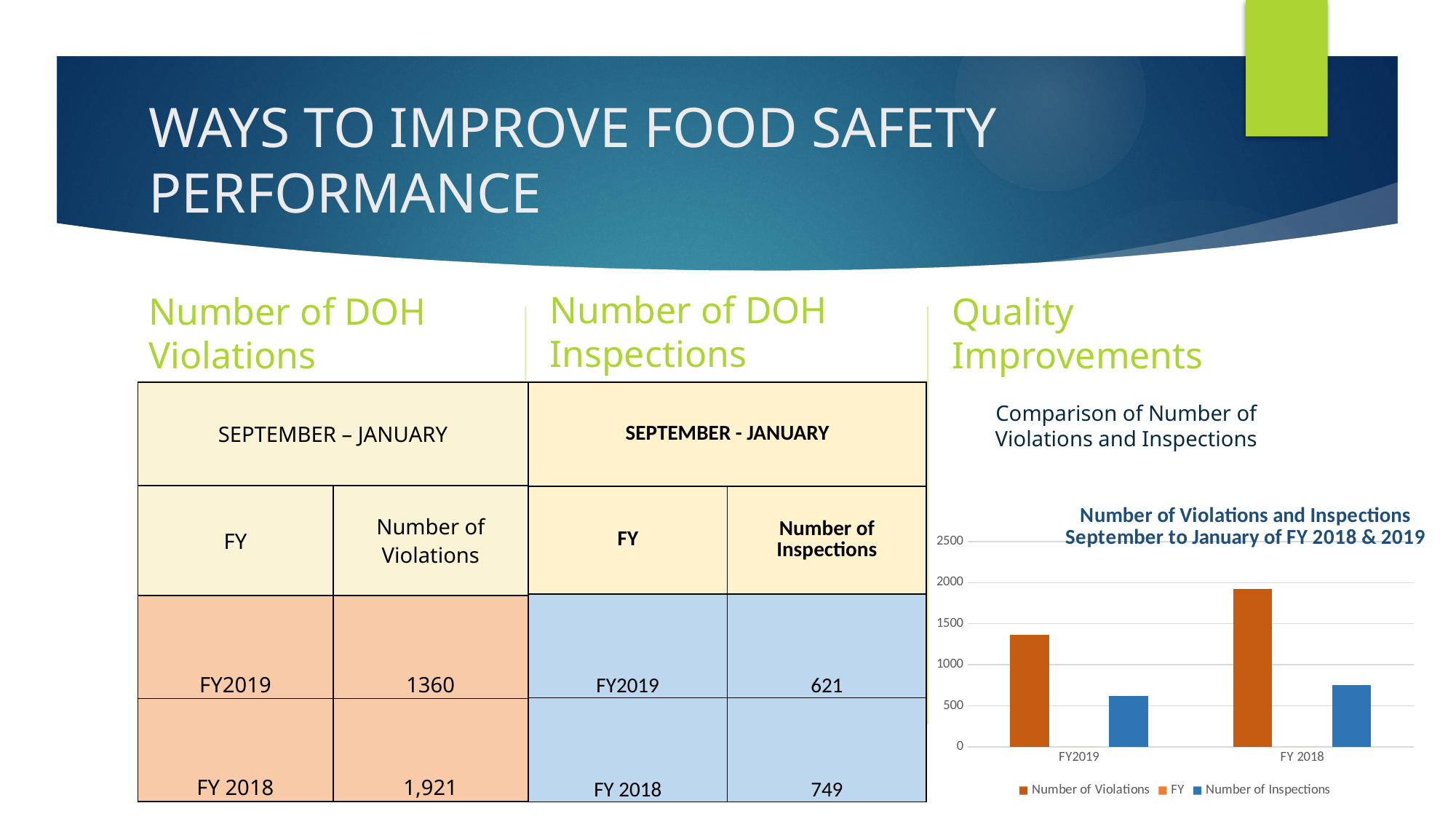
In the chart, is the Number of Violations bar for FY 2018 greater or less than 1500? greater How many entries does the chart's legend list? 3 In the chart, is the Number of Inspections bar for FY 2018 greater or less than 500? greater How many fiscal year categories are shown on the x axis of the chart? 2 In the chart, which fiscal year has the taller Number of Inspections bar, FY2019 or FY 2018? FY 2018 In the chart, which fiscal year has the taller Number of Violations bar, FY2019 or FY 2018? FY 2018 In the chart, is the Number of Violations bar for FY2019 greater or less than 1000? greater Which bar in the chart is the tallest overall? Number of Violations for FY 2018 What kind of chart is shown under Quality Improvements? bar chart What colour are the Number of Inspections bars in the chart? blue What is the title of the chart on the slide? Number of Violations and Inspections September to January of FY 2018 & 2019